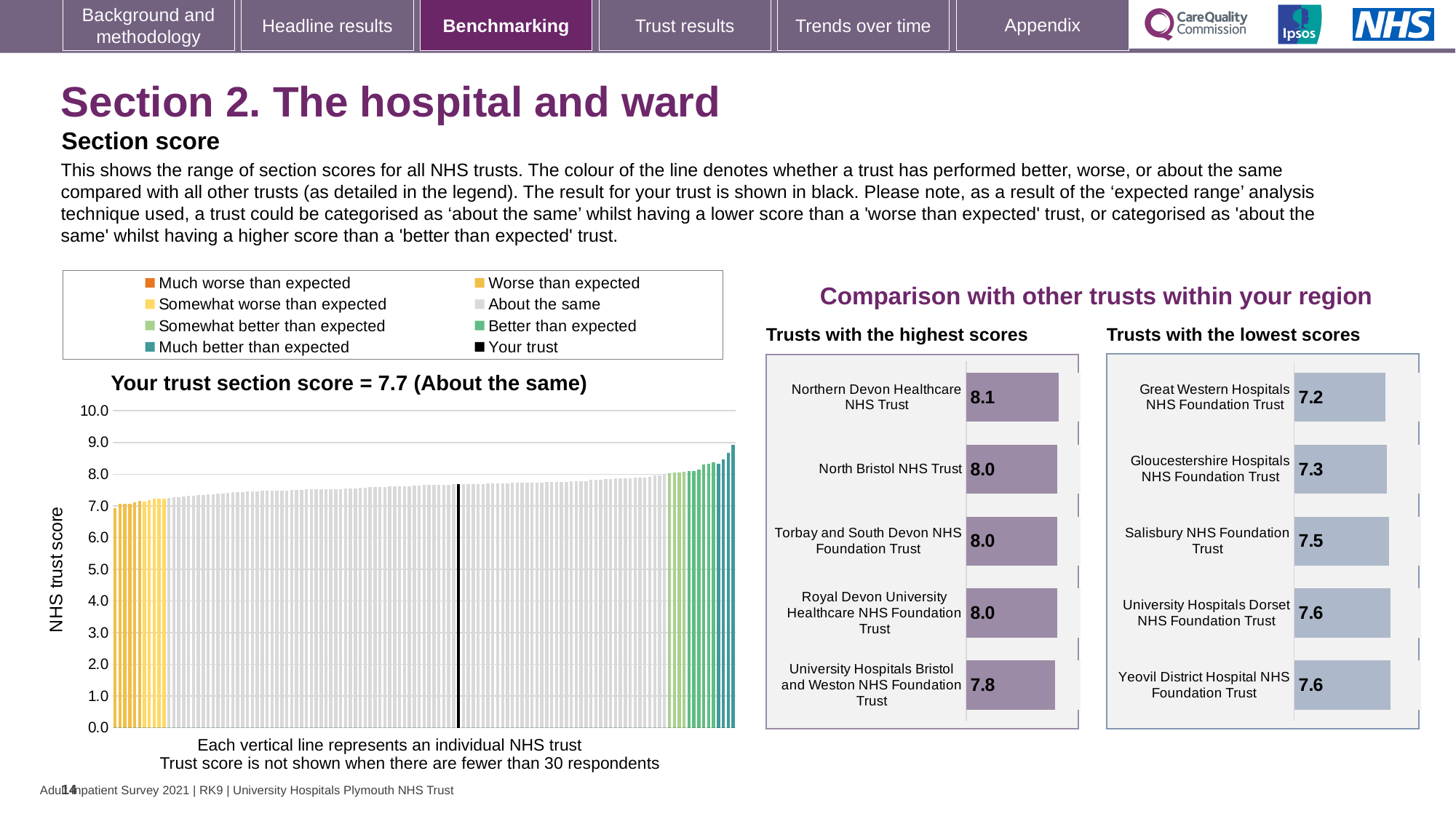
In the 'Trusts with the highest scores' chart, which trust has the lowest score? University Hospitals Bristol and Weston NHS Foundation Trust How many trusts are listed in the 'Trusts with the highest scores' chart? 5 In the 'Trusts with the lowest scores' chart, what is the difference between the scores of Salisbury NHS Foundation Trust and Great Western Hospitals NHS Foundation Trust? 0.3 In the 'Trusts with the lowest scores' chart, what is the score for Great Western Hospitals NHS Foundation Trust? 7.2 In the main chart on the left, what is the section score for your trust? 7.7 How many entries does the legend above the main chart on the left list? 8 In the 'Trusts with the highest scores' chart, what is the score for Northern Devon Healthcare NHS Trust? 8.1 In the main chart on the left, do the trust scores rise or fall from left to right? Rise In the 'Trusts with the highest scores' chart, what is the difference between the scores of Northern Devon Healthcare NHS Trust and University Hospitals Bristol and Weston NHS Foundation Trust? 0.3 In the 'Trusts with the lowest scores' chart, which trust has the lowest score? Great Western Hospitals NHS Foundation Trust What kind of chart is the main chart on the left showing the range of section scores for all NHS trusts? Bar chart In the 'Trusts with the lowest scores' chart, which has the higher score: Gloucestershire Hospitals NHS Foundation Trust or Salisbury NHS Foundation Trust? Salisbury NHS Foundation Trust